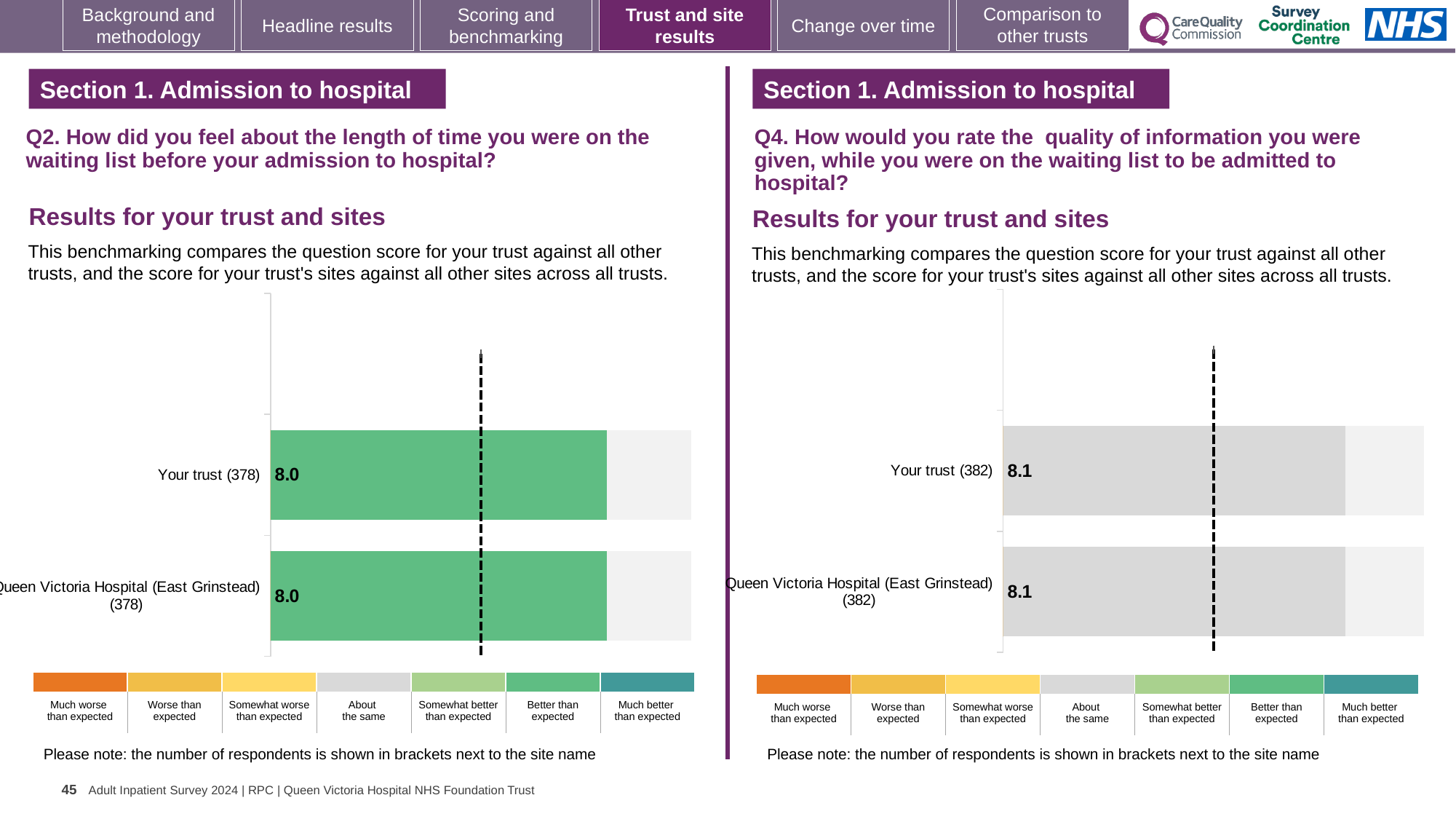
In the Q4 chart on the right, how many respondents are shown in brackets for Queen Victoria Hospital (East Grinstead)? 382 According to the colour key, which benchmark category do the green bars in the Q2 chart on the left represent? Better than expected In the Q4 chart on the right, what is the score for Your trust? 8.1 How many bars are plotted in the Q2 chart on the left? 2 In the Q2 chart on the left, what is the score for Your trust? 8.0 What kind of chart is used for the Q2 results on the left? Bar chart In the Q2 chart on the left, what is the difference between the score for Your trust and the score for Queen Victoria Hospital (East Grinstead)? 0.0 How many bars are plotted in the Q4 chart on the right? 2 In the Q4 chart on the right, what is the difference between the score for Your trust and the score for Queen Victoria Hospital (East Grinstead)? 0.0 In the Q4 chart on the right, what is the score for Queen Victoria Hospital (East Grinstead)? 8.1 In the Q2 chart on the left, how many respondents are shown in brackets for Your trust? 378 In the Q2 chart on the left, what is the score for Queen Victoria Hospital (East Grinstead)? 8.0